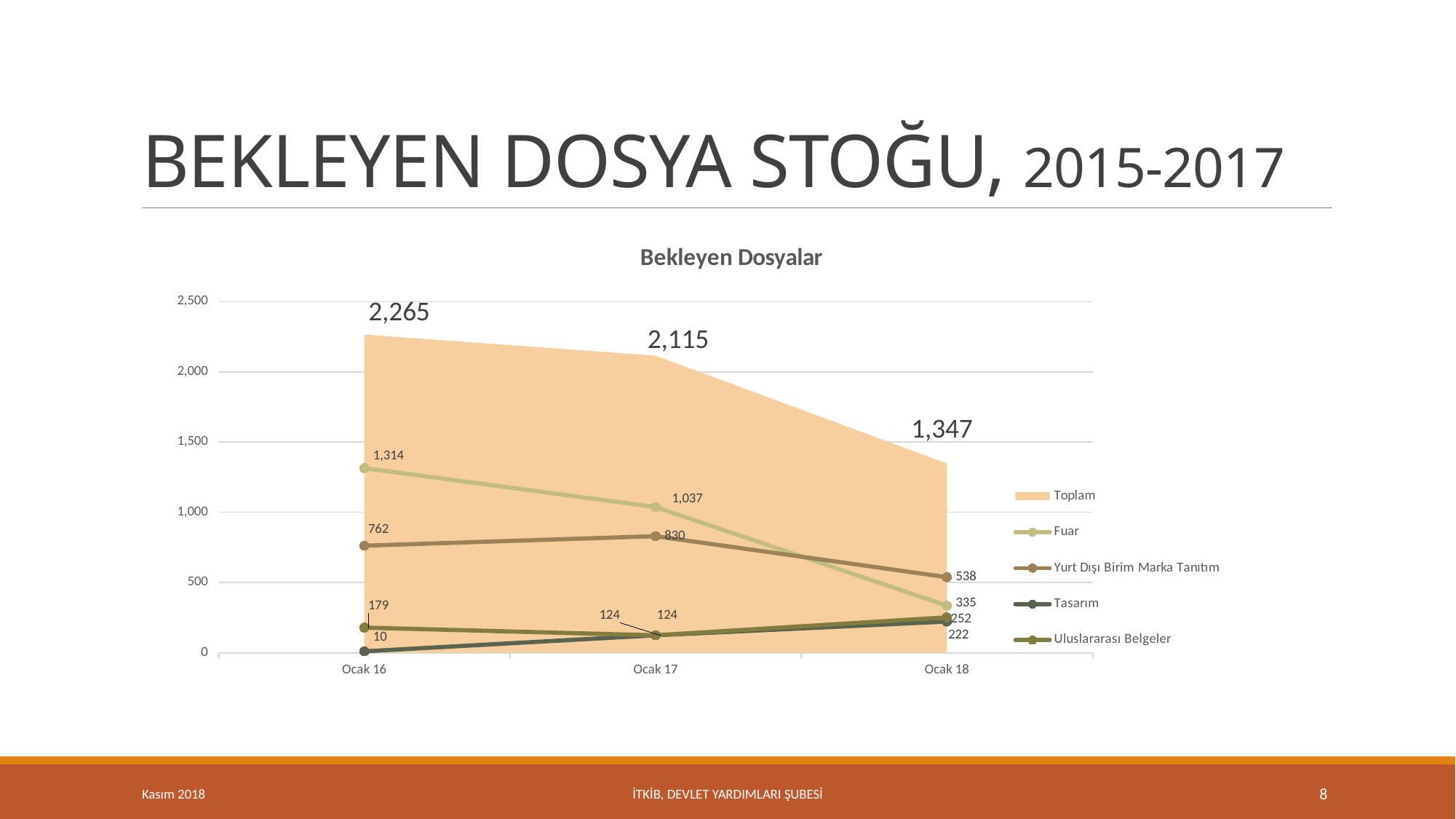
What is the value of Uluslararası Belgeler at Ocak 16? 179 Does the Fuar series rise or fall from Ocak 16 to Ocak 18? fall What is the value of Toplam at Ocak 16? 2,265 What is the value of Fuar at Ocak 17? 1,037 Which is larger at Ocak 18, Fuar or Yurt Dışı Birim Marka Tanıtım? Yurt Dışı Birim Marka Tanıtım What is the difference between Fuar and Yurt Dışı Birim Marka Tanıtım at Ocak 16? 552 By how much did Toplam fall from Ocak 16 to Ocak 18? 918 What is the value of Tasarım at Ocak 16? 10 What is the value of Yurt Dışı Birim Marka Tanıtım at Ocak 18? 538 What is the title of the chart? Bekleyen Dosyalar What is the value of Toplam at Ocak 18? 1,347 How many series does the legend list? 5